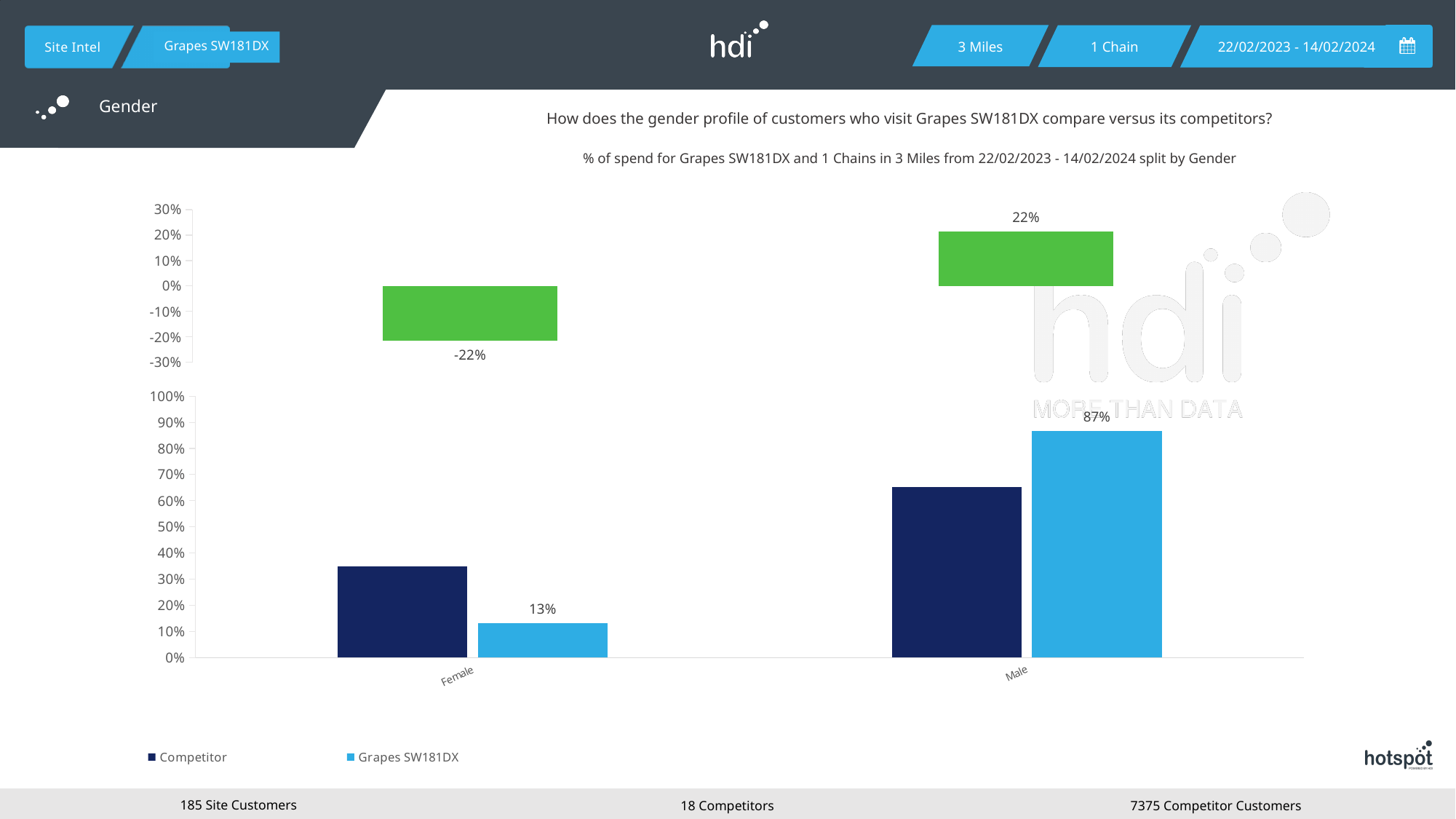
In the bottom bar chart, is the Competitor value for Male greater or less than 70%? less In the top chart, what is the value shown for the Male category? 22% In the bottom bar chart, what is the value for Grapes SW181DX in the Female category? 13% In the bottom bar chart, is the Competitor value for Female greater or less than 30%? greater In the bottom bar chart, what is the value for Grapes SW181DX in the Male category? 87% How many categories are shown on the x axis of the bottom bar chart? 2 In the bottom bar chart, which category has the higher value for Grapes SW181DX, Female or Male? Male In the top chart, what is the value shown for the Female category? -22% What type of chart is the bottom chart on the slide? Bar chart In the bottom bar chart, which series has the higher value in the Male category, Competitor or Grapes SW181DX? Grapes SW181DX How many series does the legend of the bottom bar chart list? 2 In the bottom bar chart, what is the difference between the Grapes SW181DX values for Male and Female? 74%